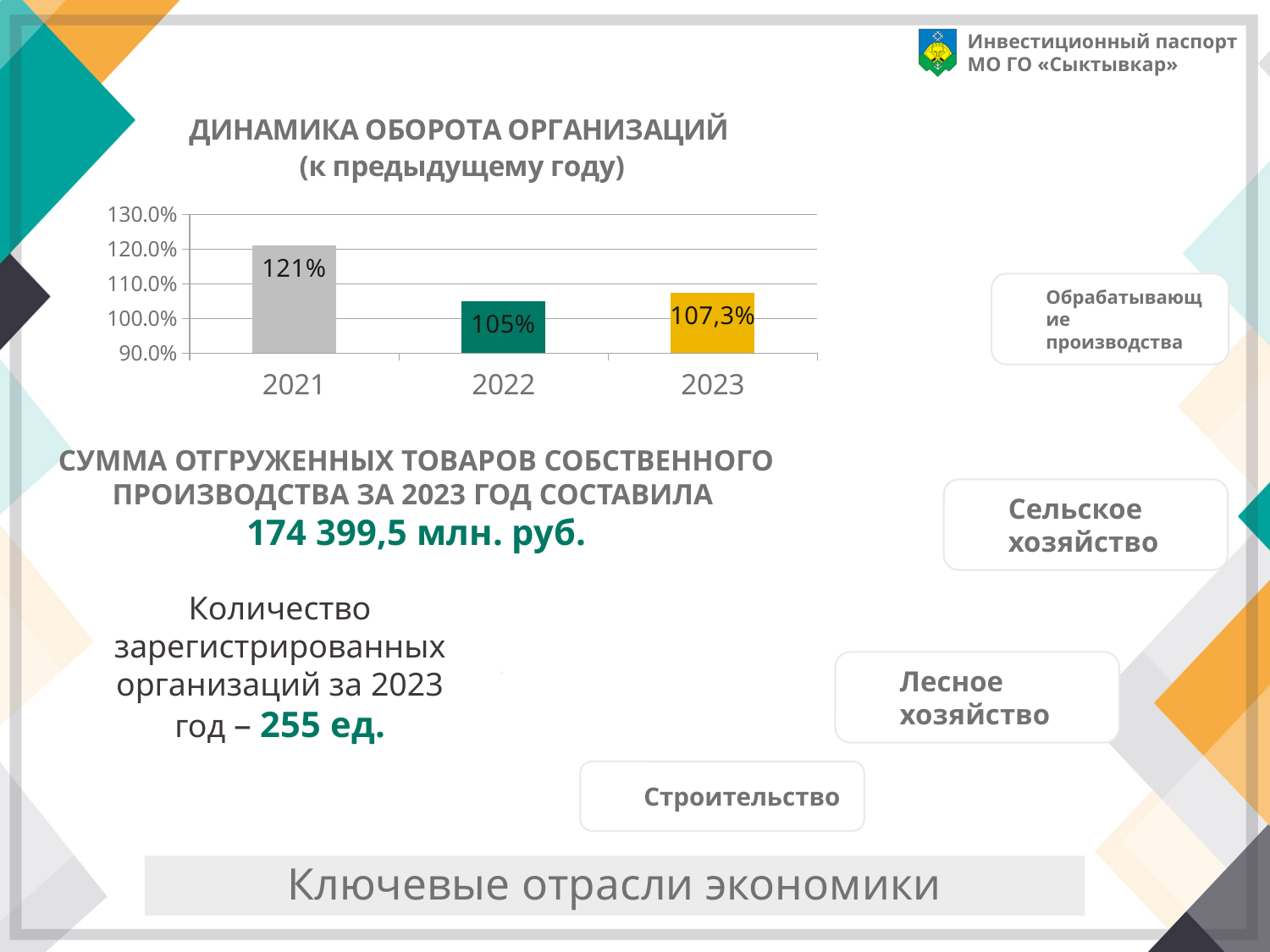
In the chart 'ДИНАМИКА ОБОРОТА ОРГАНИЗАЦИЙ', which is larger: the value for 2022 or the value for 2023? 2023 In the chart 'ДИНАМИКА ОБОРОТА ОРГАНИЗАЦИЙ', what is the difference between the 2021 value and the 2022 value? 16 percentage points What is the value for 2021 in the chart 'ДИНАМИКА ОБОРОТА ОРГАНИЗАЦИЙ'? 121% What is the value for 2022 in the chart 'ДИНАМИКА ОБОРОТА ОРГАНИЗАЦИЙ'? 105% What type of chart is 'ДИНАМИКА ОБОРОТА ОРГАНИЗАЦИЙ'? Bar chart What is the value for 2023 in the chart 'ДИНАМИКА ОБОРОТА ОРГАНИЗАЦИЙ'? 107,3% In the chart 'ДИНАМИКА ОБОРОТА ОРГАНИЗАЦИЙ', what is the difference between the 2023 value and the 2022 value? 2,3 percentage points In the chart 'ДИНАМИКА ОБОРОТА ОРГАНИЗАЦИЙ', is the value for 2021 greater or less than 110.0%? greater Which year has the lowest value in the chart 'ДИНАМИКА ОБОРОТА ОРГАНИЗАЦИЙ'? 2022 What is the subtitle shown in parentheses under the chart title 'ДИНАМИКА ОБОРОТА ОРГАНИЗАЦИЙ'? (к предыдущему году) Which year has the highest value in the chart 'ДИНАМИКА ОБОРОТА ОРГАНИЗАЦИЙ'? 2021 How many years are shown in the chart 'ДИНАМИКА ОБОРОТА ОРГАНИЗАЦИЙ'? 3